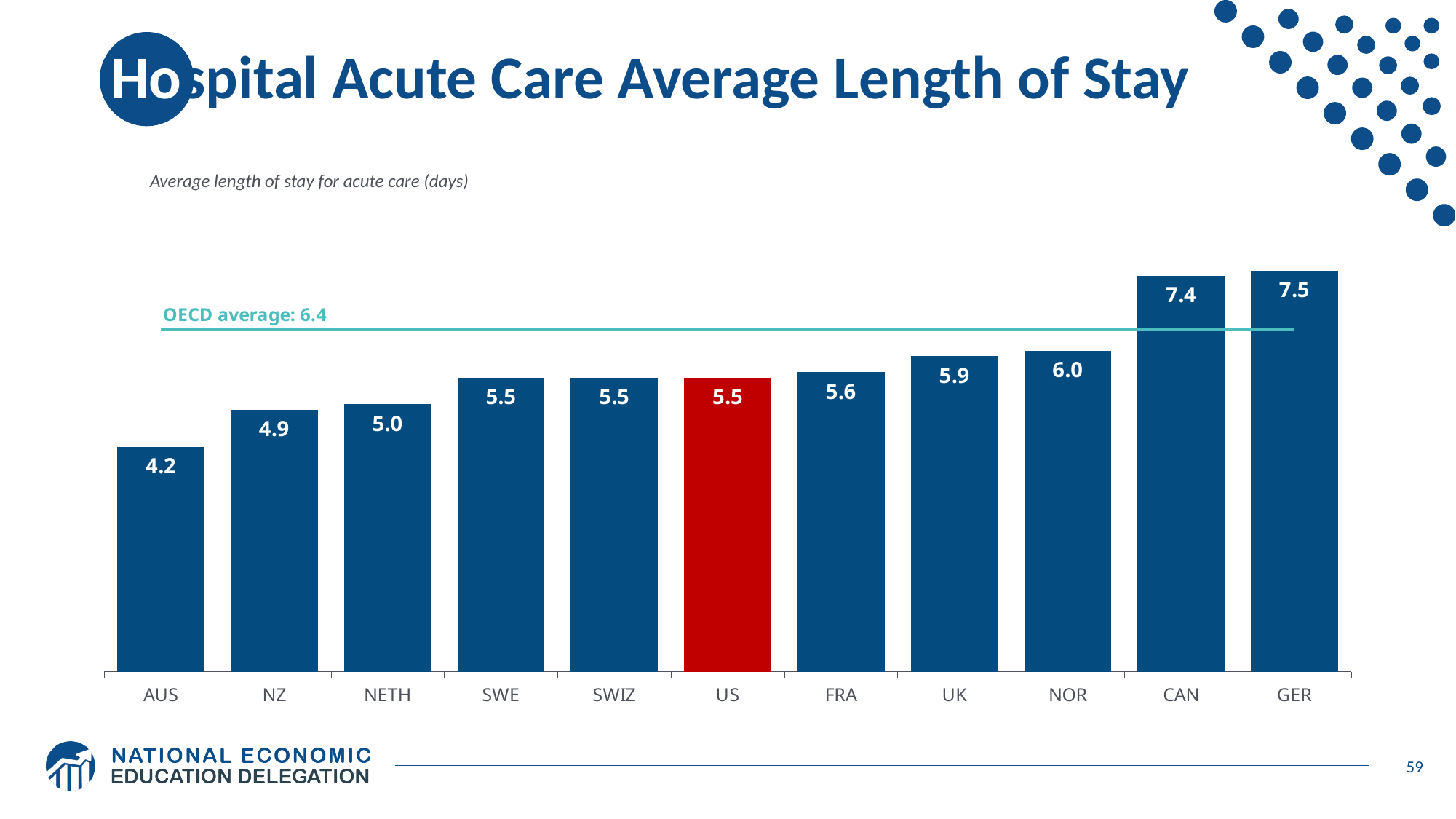
What is the difference between the values for CAN and AUS? 3.2 What kind of chart is shown on the slide? Bar chart What is the value shown for AUS? 4.2 Which country has the lowest average length of stay? AUS What is the OECD average shown on the chart? 6.4 What is the average length of stay for acute care in the US? 5.5 What is the average length of stay for acute care in Germany (GER)? 7.5 Which country's bar is coloured red? US What is the difference between the values for NOR and NETH? 1.0 How many countries are shown in the chart? 11 Which has a higher average length of stay, UK or NZ? UK Which country has the highest average length of stay? GER